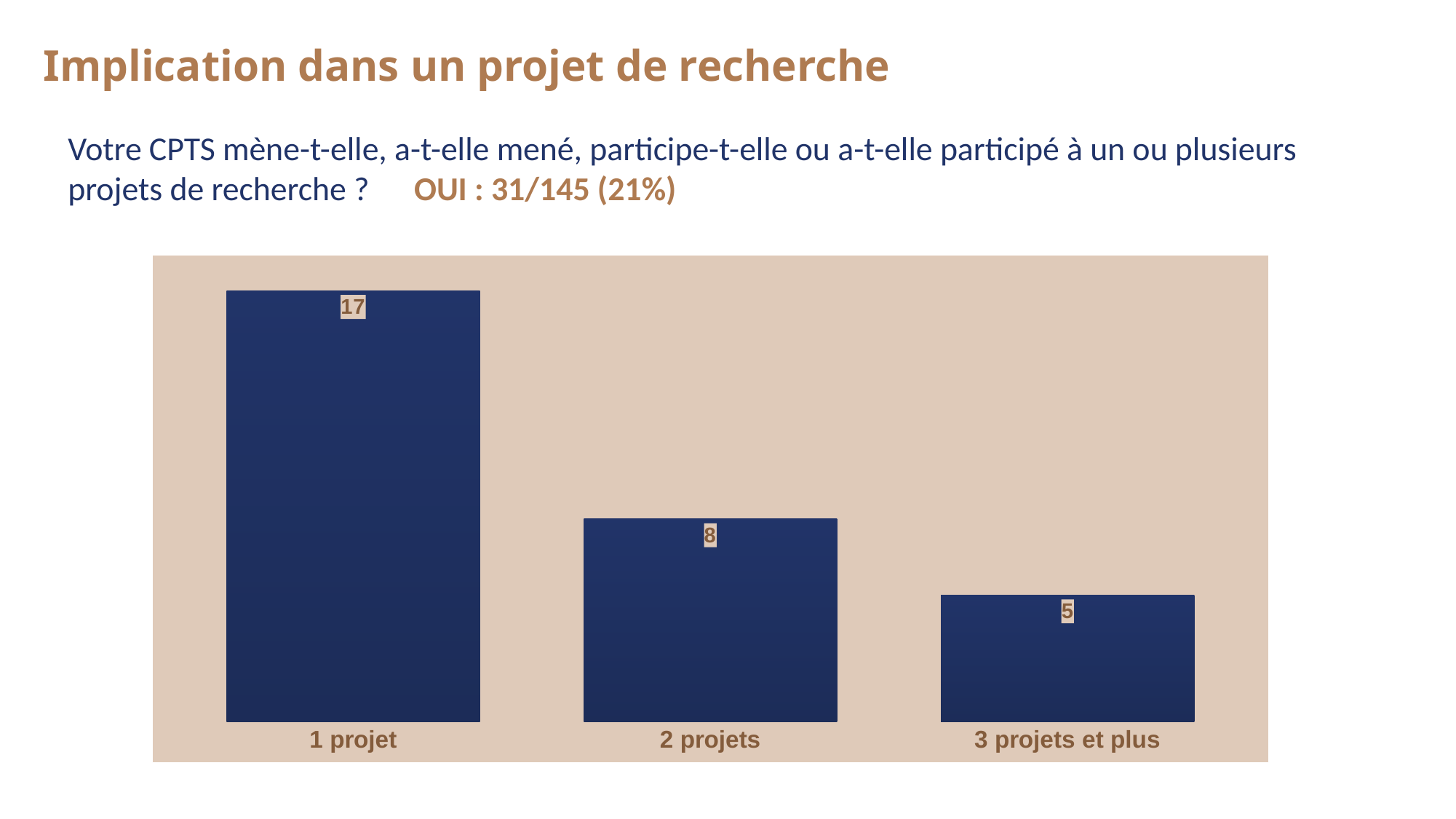
Which category has the lowest value? 3 projets et plus What is the total of the three values shown in the chart? 30 What is the difference between the values for "1 projet" and "2 projets"? 9 What is the value for "2 projets"? 8 Which is larger, the value for "2 projets" or the value for "3 projets et plus"? 2 projets What is the value for "1 projet"? 17 What is the difference between the values for "2 projets" and "3 projets et plus"? 3 What kind of chart is shown on the slide? bar chart How many categories are shown in the chart? 3 Do the values rise or fall from left to right along the x axis? fall Which category has the highest value? 1 projet What is the value for "3 projets et plus"? 5